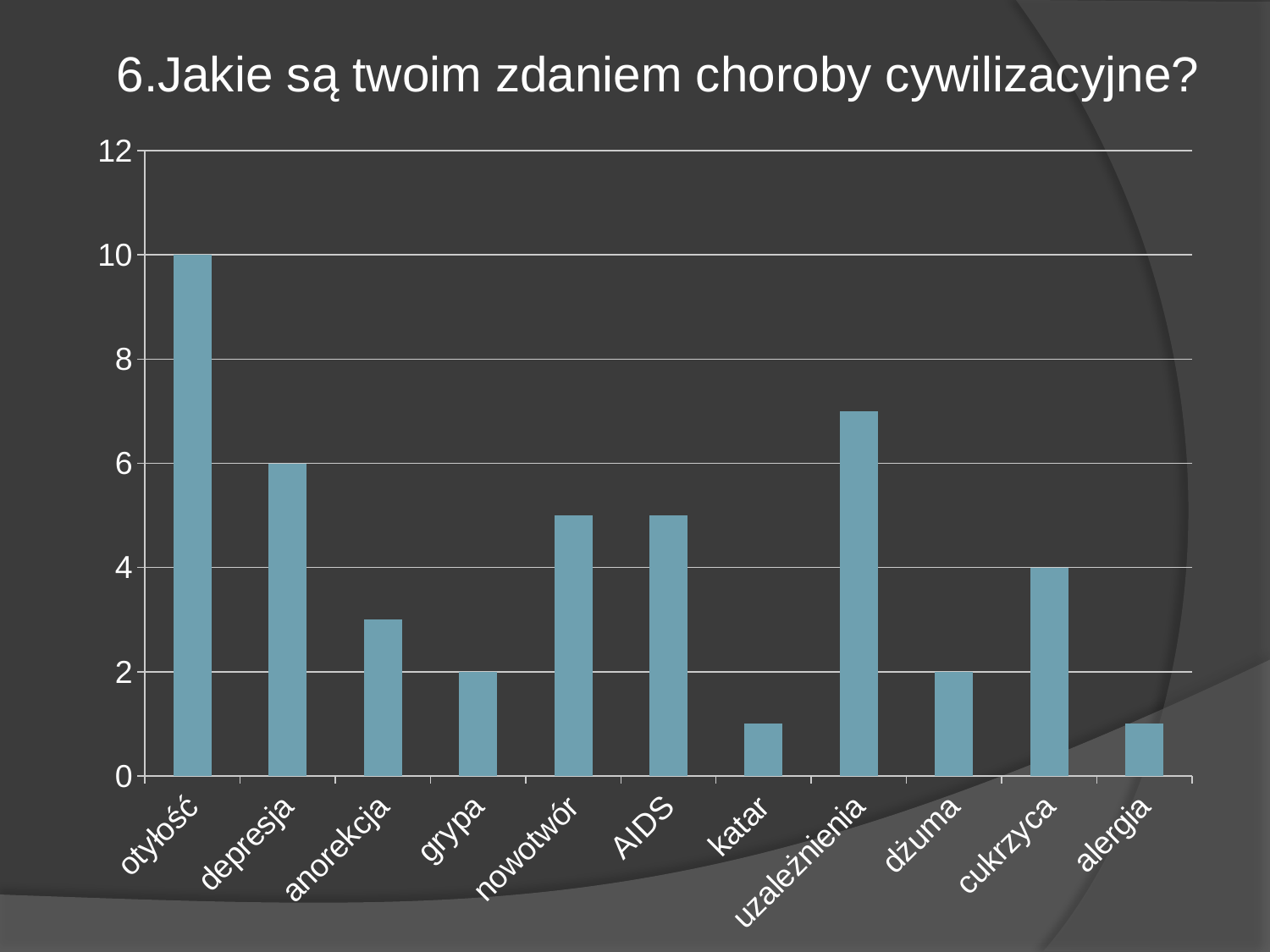
Is the value for nowotwór greater or less than 4? greater Which category has the highest value? otyłość How many categories are shown on the x axis? 11 Which is larger, the value for uzależnienia or the value for depresja? uzależnienia Is the value for katar greater or less than 2? less What kind of chart is shown on the slide? bar chart What is the value for otyłość? 10 What is the value for cukrzyca? 4 What is the value for grypa? 2 What is the difference between the values for otyłość and depresja? 4 What is the value for depresja? 6 Is the value for uzależnienia greater or less than 6? greater